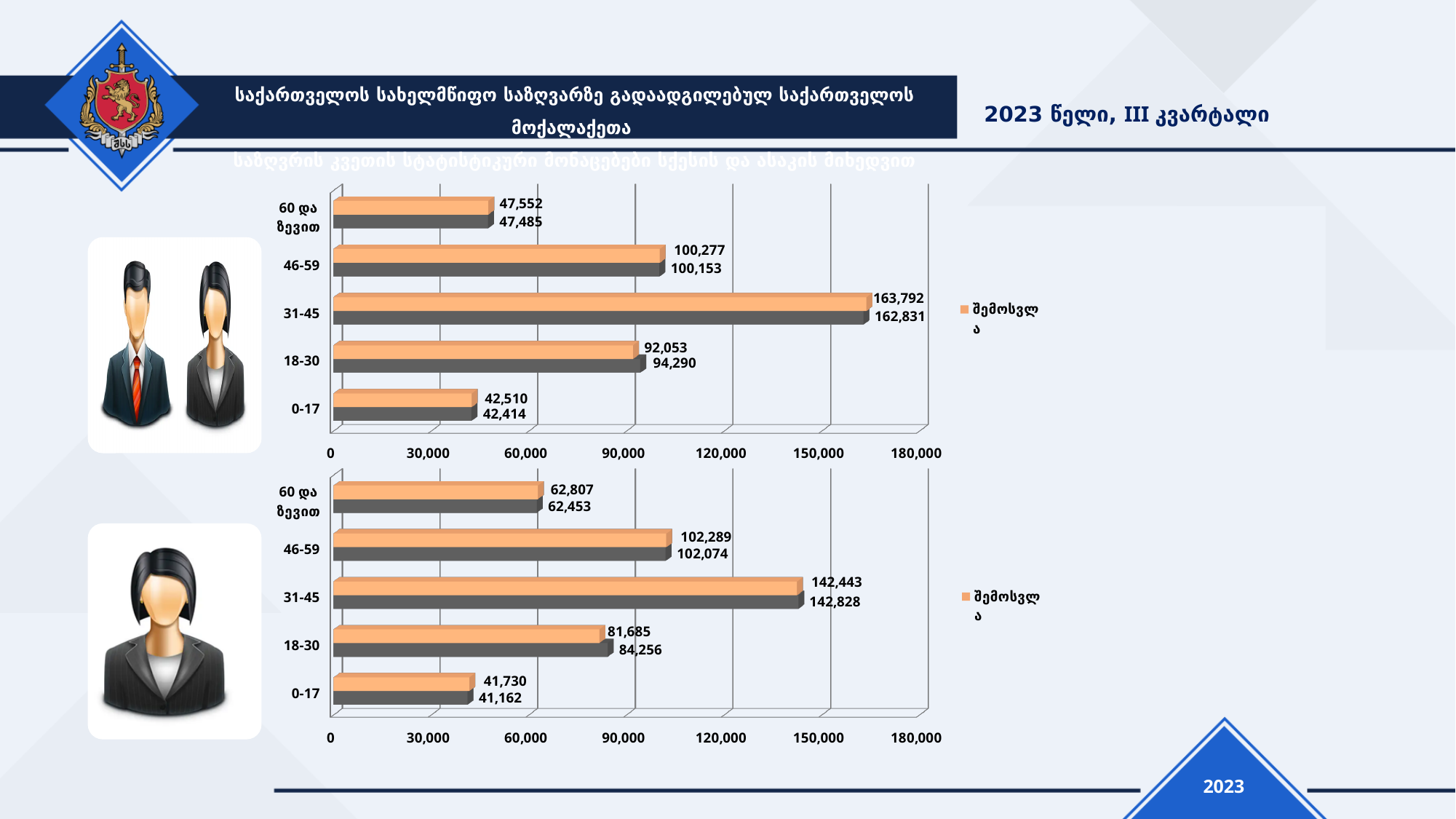
In the bottom chart, which age group has the lowest orange bar value? 0-17 In the top chart, what is the value of the gray bar for the 18-30 age group? 94,290 What type of chart is the bottom chart? Bar chart What legend entry is shown next to the top chart? შემოსვლა In the top chart, what is the value of the orange bar for the 31-45 age group? 163,792 In the top chart, what is the difference between the orange bar values for 31-45 and 46-59? 63,515 How many age group categories are shown in the top chart? 5 In the top chart, which age group has the highest orange bar value? 31-45 In the bottom chart, what is the value of the gray bar for the 0-17 age group? 41,162 In the bottom chart, what is the value of the orange bar for the '60 და ზევით' age group? 62,807 In the bottom chart, which orange bar is larger: 46-59 or 18-30? 46-59 In the bottom chart, what is the difference between the gray bar and the orange bar for the 18-30 age group? 2,571